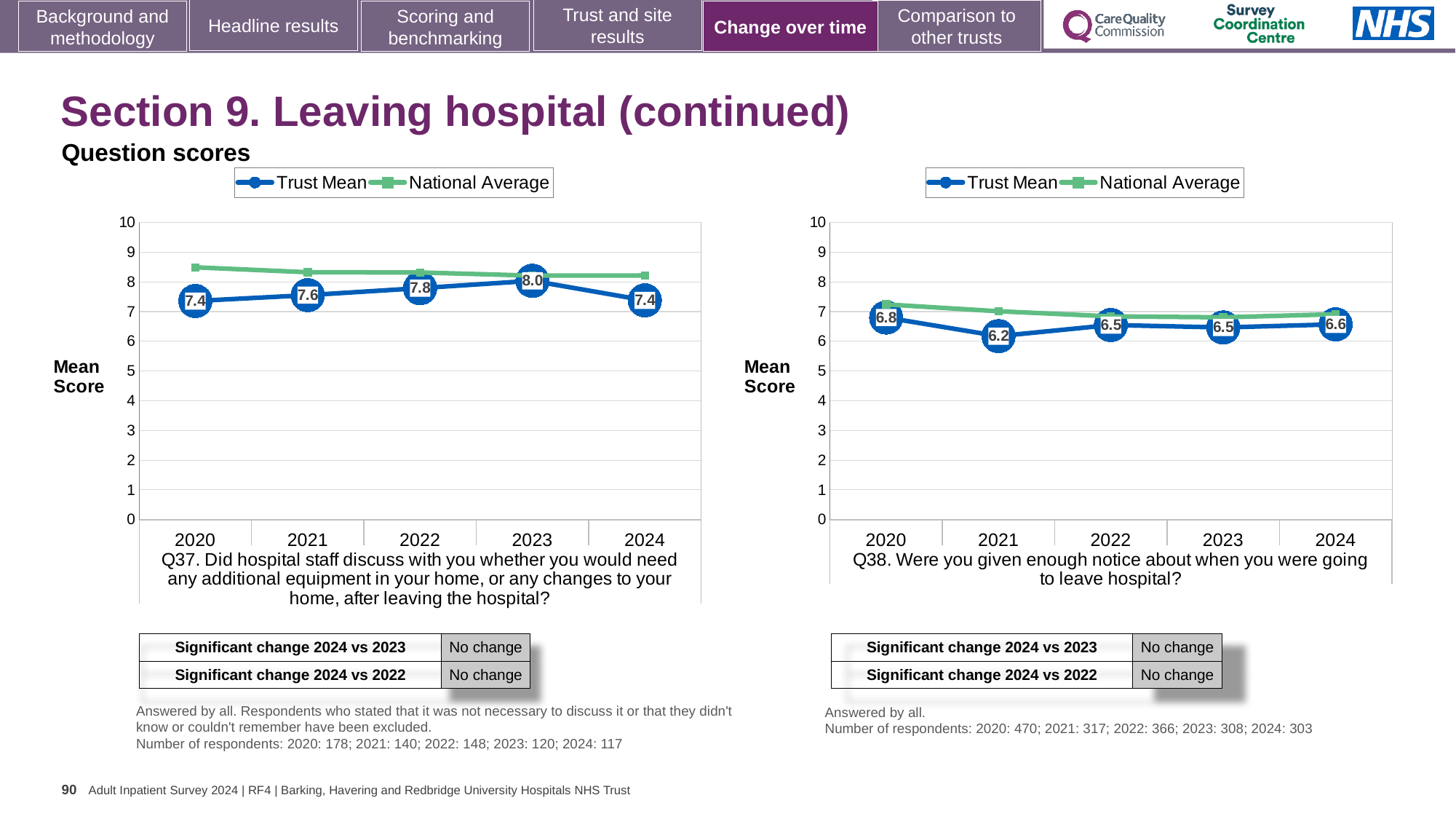
How many years are plotted on the x axis of the Q37 chart (left)? 5 On the Q38 chart (right), is the Trust Mean score for 2020 larger or smaller than the Trust Mean score for 2024? larger On the Q38 chart (right), what is the Trust Mean score for 2021? 6.2 On the Q37 chart (left), which year has the highest Trust Mean score? 2023 How many series does the legend of the Q38 chart (right) list? 2 On the Q37 chart (left), is the National Average for 2020 greater or less than 8? greater On the Q37 chart (left), what is the difference between the Trust Mean scores for 2023 and 2022? 0.2 On the Q37 chart (left), what is the Trust Mean score for 2023? 8.0 On the Q38 chart (right), which year has the highest Trust Mean score? 2020 On the Q38 chart (right), which year has the lowest Trust Mean score? 2021 On the Q37 chart (left), what is the Trust Mean score for 2020? 7.4 On the Q38 chart (right), what is the difference between the Trust Mean scores for 2020 and 2021? 0.6